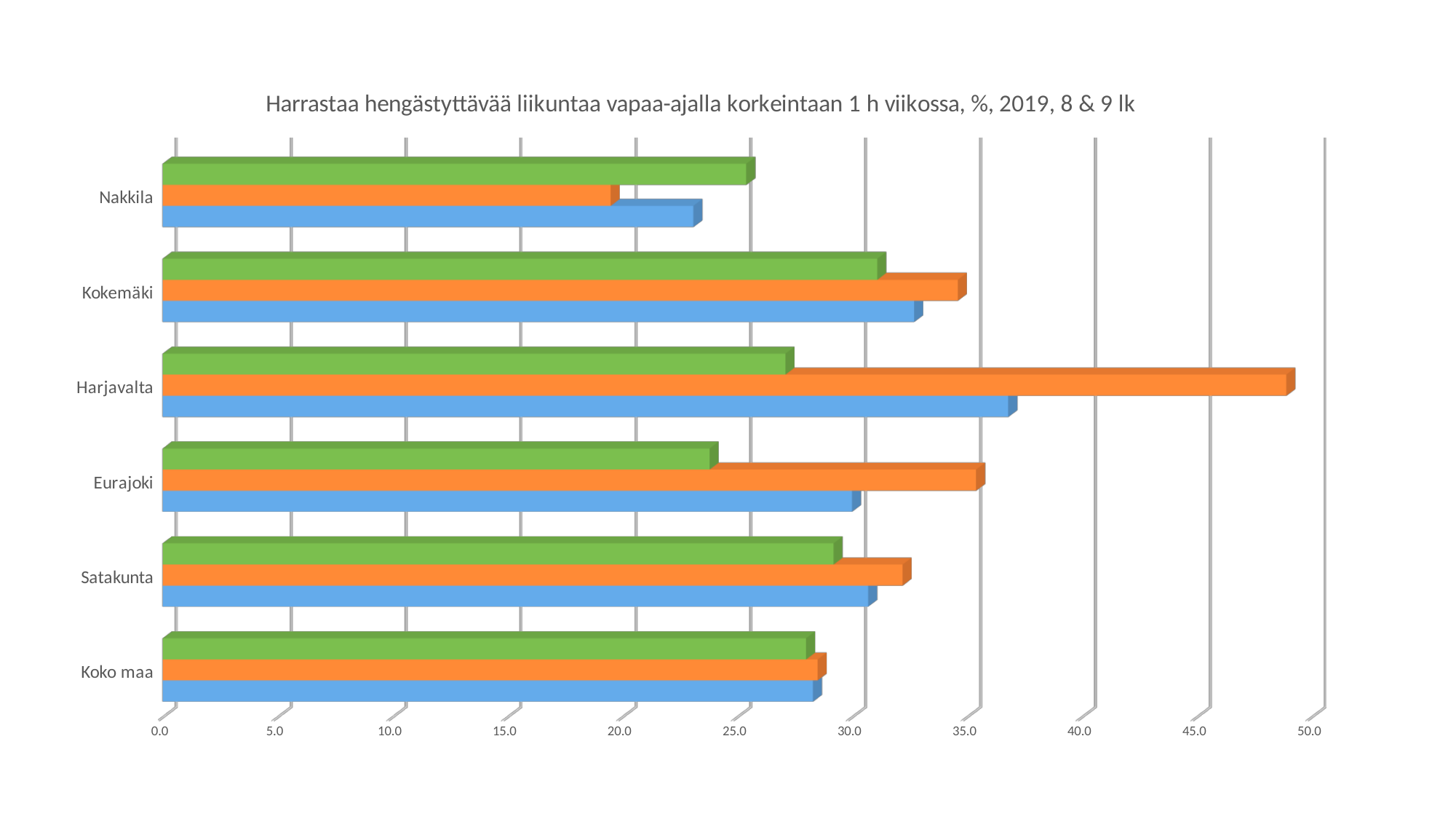
What is the highest value shown on the horizontal axis? 50.0 For Nakkila, which is larger: the blue bar or the orange bar? the blue bar What kind of chart is shown on the slide? bar chart Is the green bar for Eurajoki greater or less than 25.0? less Which category has the shortest orange bar? Nakkila Which category has the shortest blue bar? Nakkila Is the orange bar for Harjavalta greater or less than 45.0? greater How many categories are shown on the vertical axis of the chart? 6 Is the blue bar for Harjavalta greater or less than 35.0? greater Which category has the longest orange bar? Harjavalta For Eurajoki, which is larger: the orange bar or the green bar? the orange bar